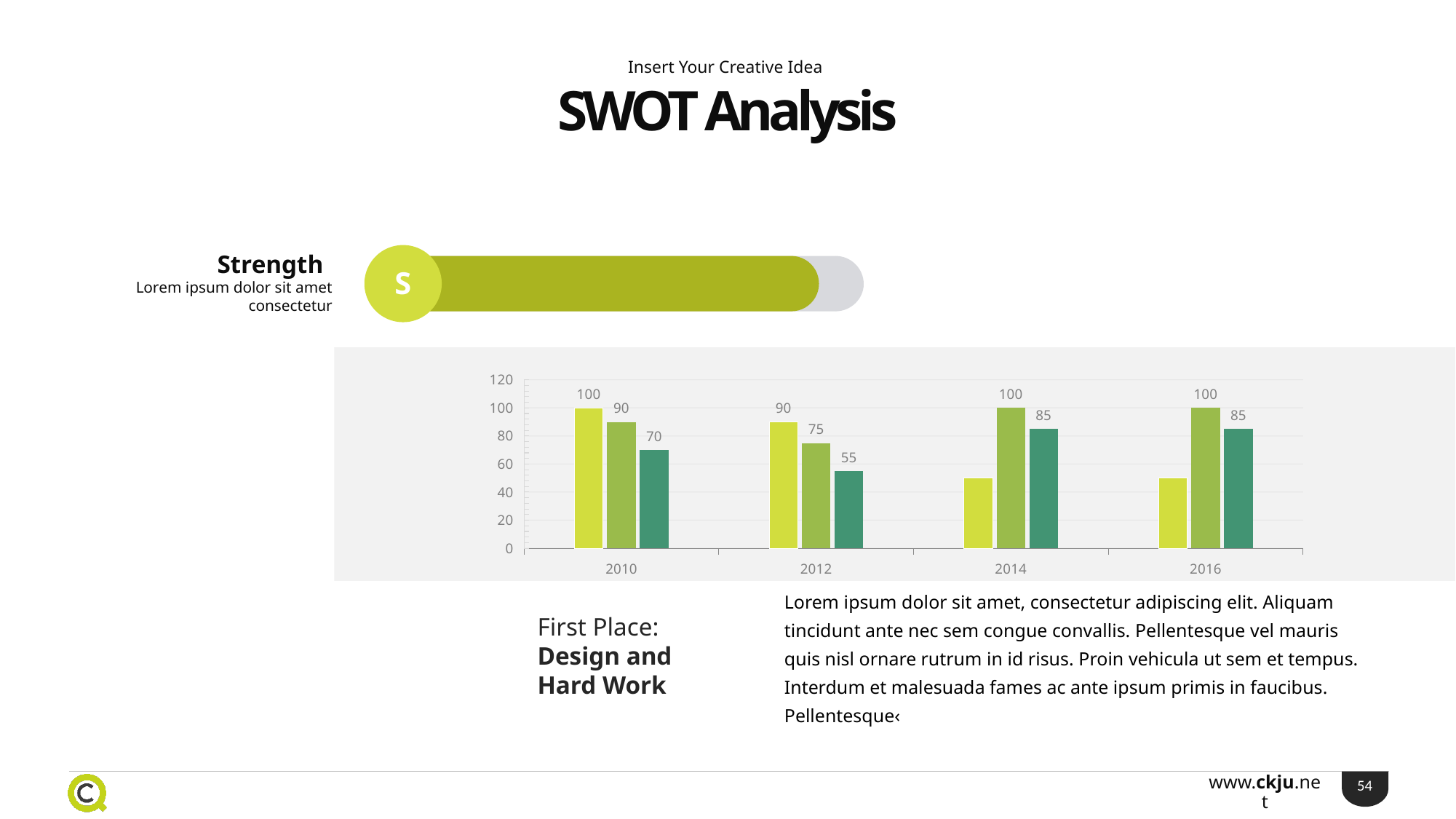
How many year categories are shown on the x axis of the chart? 4 What is the difference between the second bar for 2012 and the second bar for 2014? 25 How many bars are shown for each year in the chart? 3 Which is larger, the second bar for 2010 or the second bar for 2012? 2010 Which year has the lowest value for the third (darkest green) bar? 2012 What is the value of the second (medium green) bar for 2014? 100 Is the value of the first (lightest green) bar for 2014 greater or less than 80? less What is the value of the first (lightest green) bar for 2010? 100 What kind of chart is shown on the slide? bar chart What is the difference between the first and third bars for 2010? 30 What is the value of the third (darkest green) bar for 2016? 85 What is the value of the third (darkest green) bar for 2012? 55